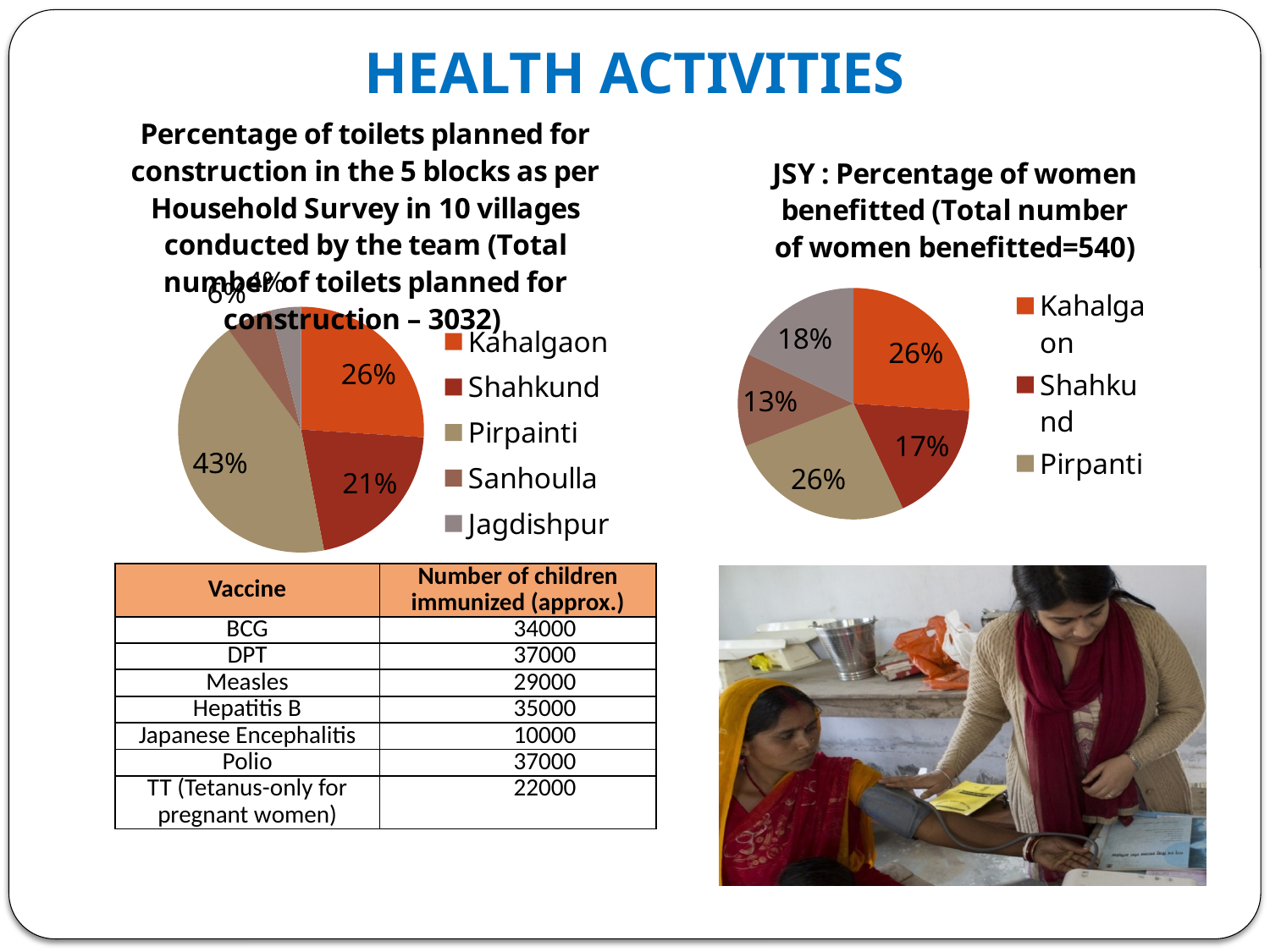
How many blocks are listed in the legend of the chart about toilets planned for construction? 5 In the JSY chart on the right, what percentage is shown for Kahalgaon? 26% In the chart about toilets planned for construction, how many percentage points larger is Pirpainti's share than Kahalgaon's? 17 percentage points According to the title of the JSY chart on the right, what is the total number of women benefitted? 540 In the chart about toilets planned for construction, what percentage is shown for Pirpainti? 43% In the JSY chart on the right, how many percentage points larger is Kahalgaon's share than Shahkund's? 9 percentage points In the chart about toilets planned for construction, what percentage is shown for Kahalgaon? 26% What kind of chart is the chart titled 'Percentage of toilets planned for construction in the 5 blocks'? Pie chart In the chart about toilets planned for construction, which block has the largest share? Pirpainti In the JSY chart on the right, what percentage is shown for Shahkund? 17% In the chart about toilets planned for construction, which has the larger share, Kahalgaon or Shahkund? Kahalgaon In the chart about toilets planned for construction, what percentage is shown for Shahkund? 21%